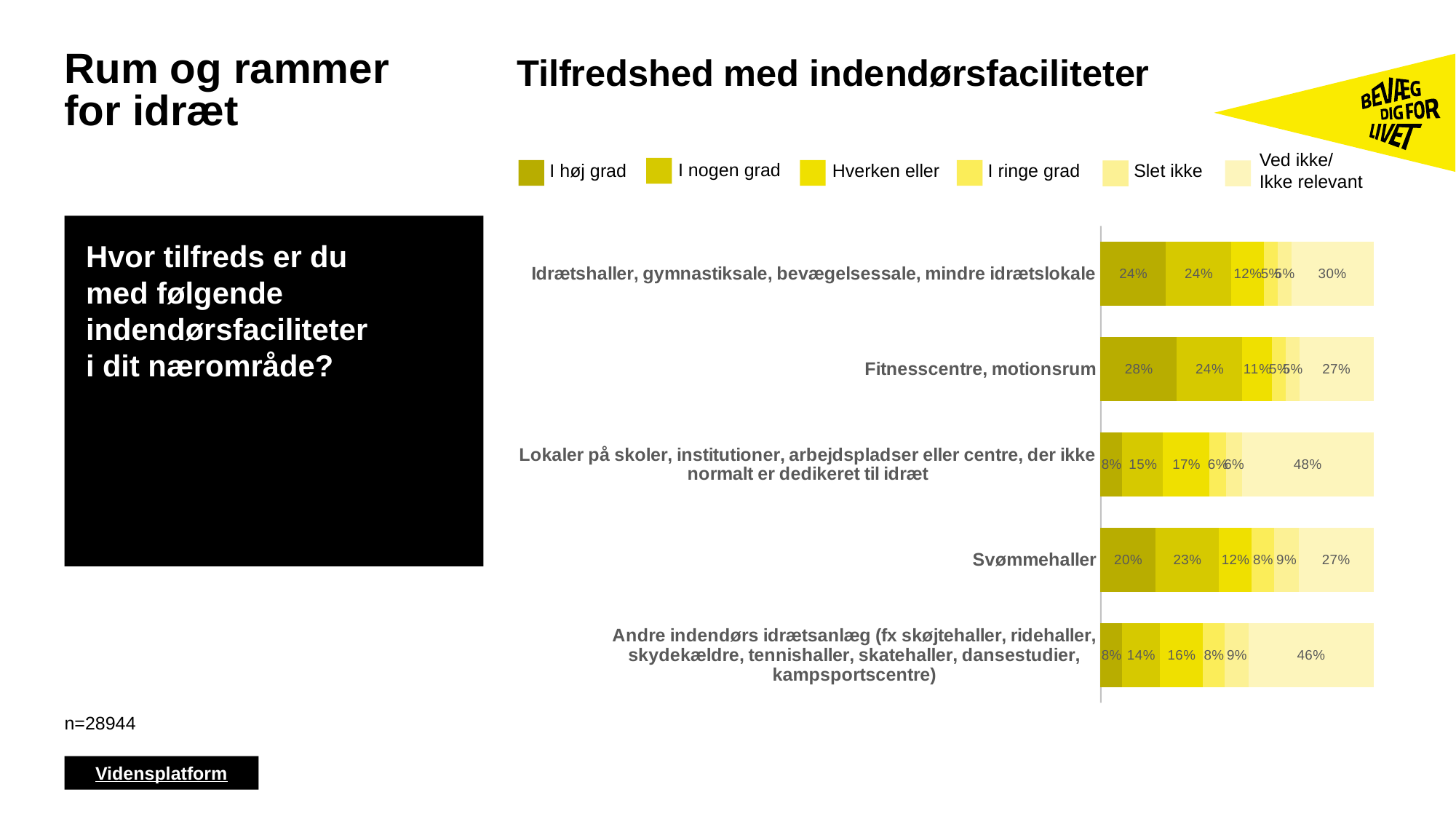
Which has the larger 'Hverken eller' share: 'Lokaler på skoler...' or 'Svømmehaller'? Lokaler på skoler... What is the 'I høj grad' value for 'Fitnesscentre, motionsrum'? 28% What kind of chart is shown under the title 'Tilfredshed med indendørsfaciliteter'? Stacked bar chart How many series does the legend of the chart list? 6 Which category has the highest 'Ved ikke/Ikke relevant' share? Lokaler på skoler, institutioner, arbejdspladser eller centre, der ikke normalt er dedikeret til idræt How many facility categories are plotted in the chart? 5 Which category has the highest 'I høj grad' share? Fitnesscentre, motionsrum What is the 'I nogen grad' value for 'Andre indendørs idrætsanlæg'? 14% What is the difference in 'Ved ikke/Ikke relevant' share between 'Idrætshaller, gymnastiksale, bevægelsessale, mindre idrætslokale' (30%) and 'Svømmehaller' (27%)? 3 percentage points What is the first entry in the chart's legend? I høj grad What is the 'Slet ikke' value for 'Svømmehaller'? 9% What is the 'Ved ikke/Ikke relevant' value for 'Lokaler på skoler, institutioner, arbejdspladser eller centre, der ikke normalt er dedikeret til idræt'? 48%